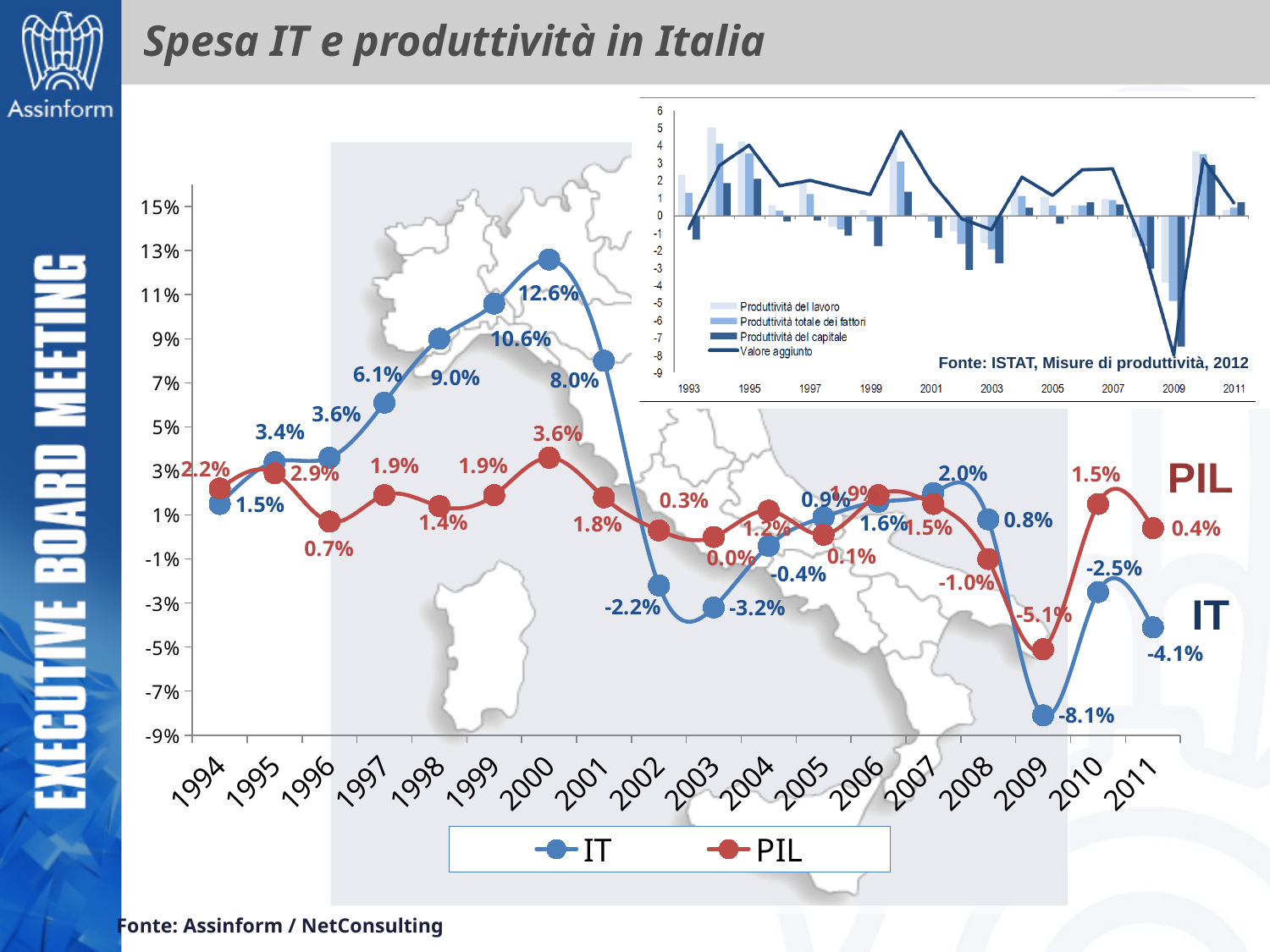
In the main line chart, what is the PIL value for 1996? 0.7% In the main line chart, what is the IT value for 2000? 12.6% In the main line chart, does the IT series rise or fall from 1994 to 2000? Rise In the main line chart, which series has the higher value in 2009, IT or PIL? PIL In the main line chart, what is the difference between the IT values for 2000 and 2001? 4.6 percentage points In the main line chart, how many years are shown on the x axis? 18 In the main line chart, what is the IT value for 2009? -8.1% In the inset chart at the top right, how many entries does the legend list? 4 In the main line chart, in which year does the IT series reach its highest value? 2000 In the main line chart, in which year does the PIL series reach its lowest value? 2009 In the main line chart, how many series does the legend list? 2 What kind of chart is the main chart with the IT and PIL series? Line chart